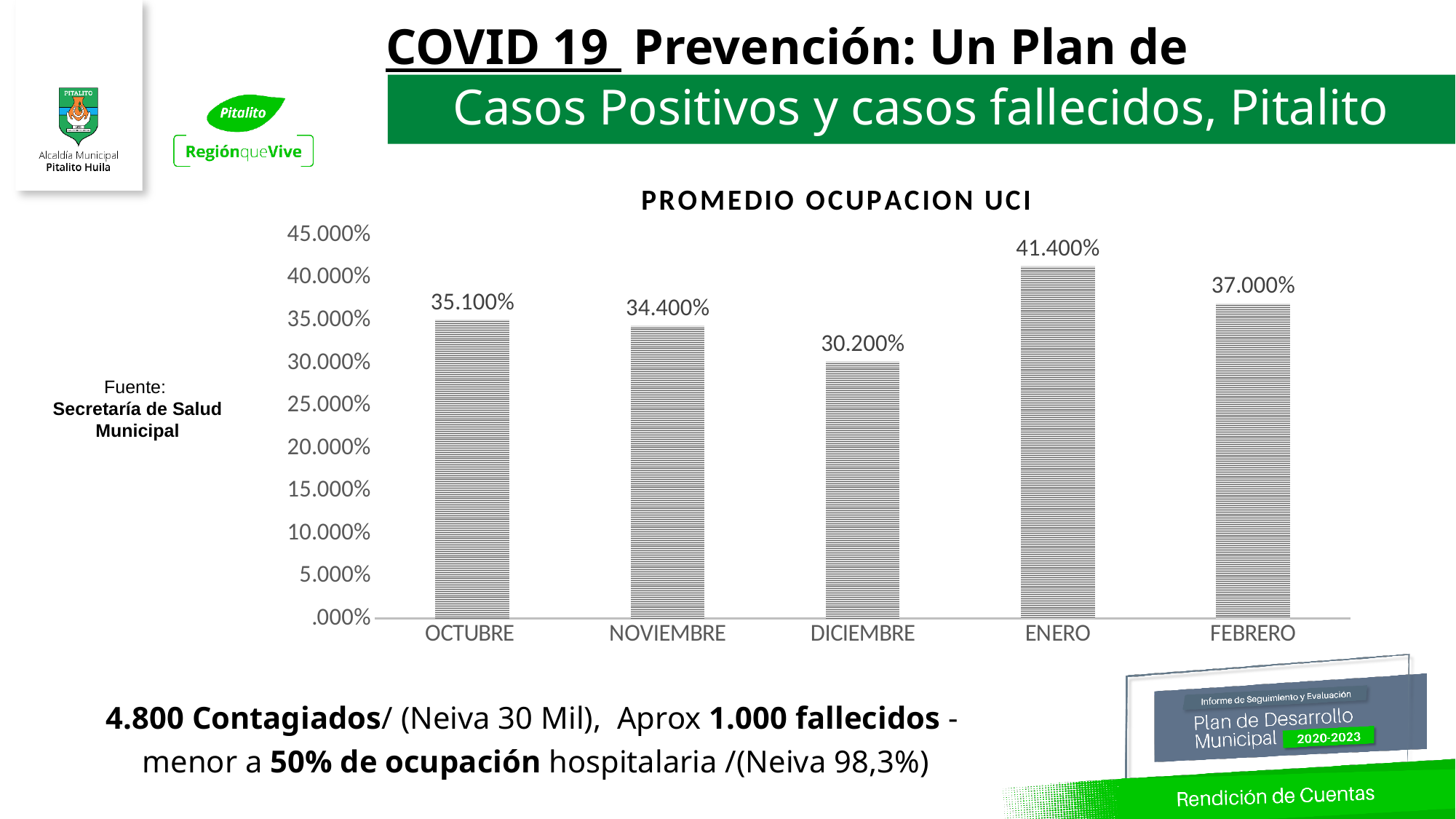
Which month has the lowest value in the PROMEDIO OCUPACION UCI chart? DICIEMBRE What is the value for OCTUBRE in the PROMEDIO OCUPACION UCI chart? 35.100% What kind of chart is the PROMEDIO OCUPACION UCI chart? bar chart What is the title of the chart on the slide? PROMEDIO OCUPACION UCI Does the value rise or fall from DICIEMBRE to ENERO in the PROMEDIO OCUPACION UCI chart? rise Is the value for FEBRERO in the PROMEDIO OCUPACION UCI chart greater or less than 35.000%? greater Which month has the highest value in the PROMEDIO OCUPACION UCI chart? ENERO Which is larger in the PROMEDIO OCUPACION UCI chart, the value for OCTUBRE or the value for NOVIEMBRE? OCTUBRE What is the difference between the values for ENERO and DICIEMBRE in the PROMEDIO OCUPACION UCI chart? 11.200% How many months are shown on the x axis of the PROMEDIO OCUPACION UCI chart? 5 What is the value for ENERO in the PROMEDIO OCUPACION UCI chart? 41.400% What is the value for DICIEMBRE in the PROMEDIO OCUPACION UCI chart? 30.200%